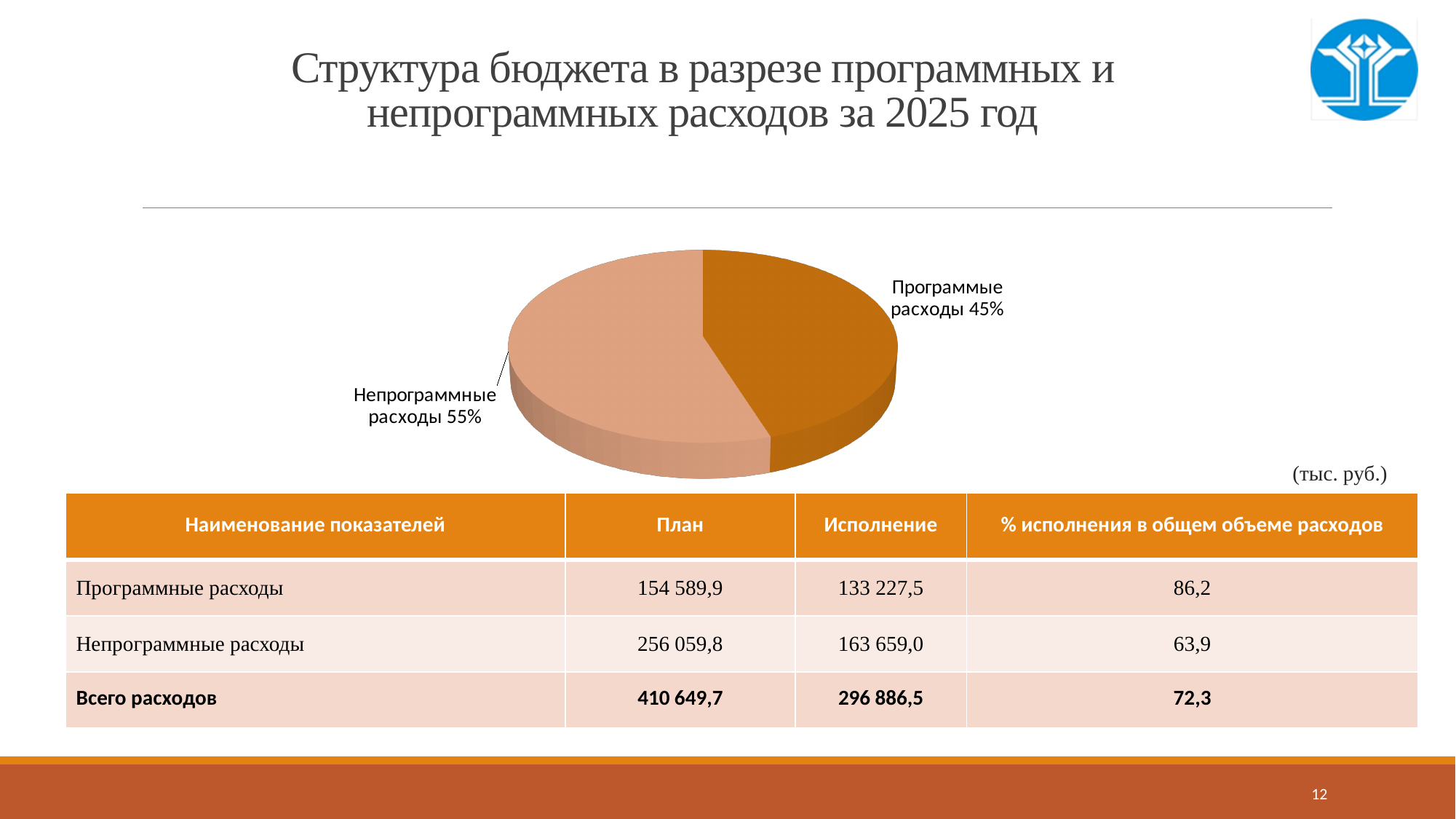
Which slice of the pie chart is drawn in the darker orange colour? Программные расходы How many slices does the pie chart have? 2 What is the title of the slide containing the pie chart? Структура бюджета в разрезе программных и непрограммных расходов за 2025 год What kind of chart is shown on the slide? Pie chart Is the share of Непрограммные расходы in the pie chart greater or less than 50%? greater What share of the pie chart is labelled "Непрограммные расходы"? 55% What share of the pie chart is labelled "Программные расходы"? 45% Which slice of the pie chart is the smallest? Программные расходы Is the share of Программные расходы in the pie chart greater or less than 50%? less By how many percentage points does the Непрограммные расходы slice exceed the Программные расходы slice in the pie chart? 10 In the pie chart, which is larger: Программные расходы or Непрограммные расходы? Непрограммные расходы Which slice of the pie chart is the largest? Непрограммные расходы